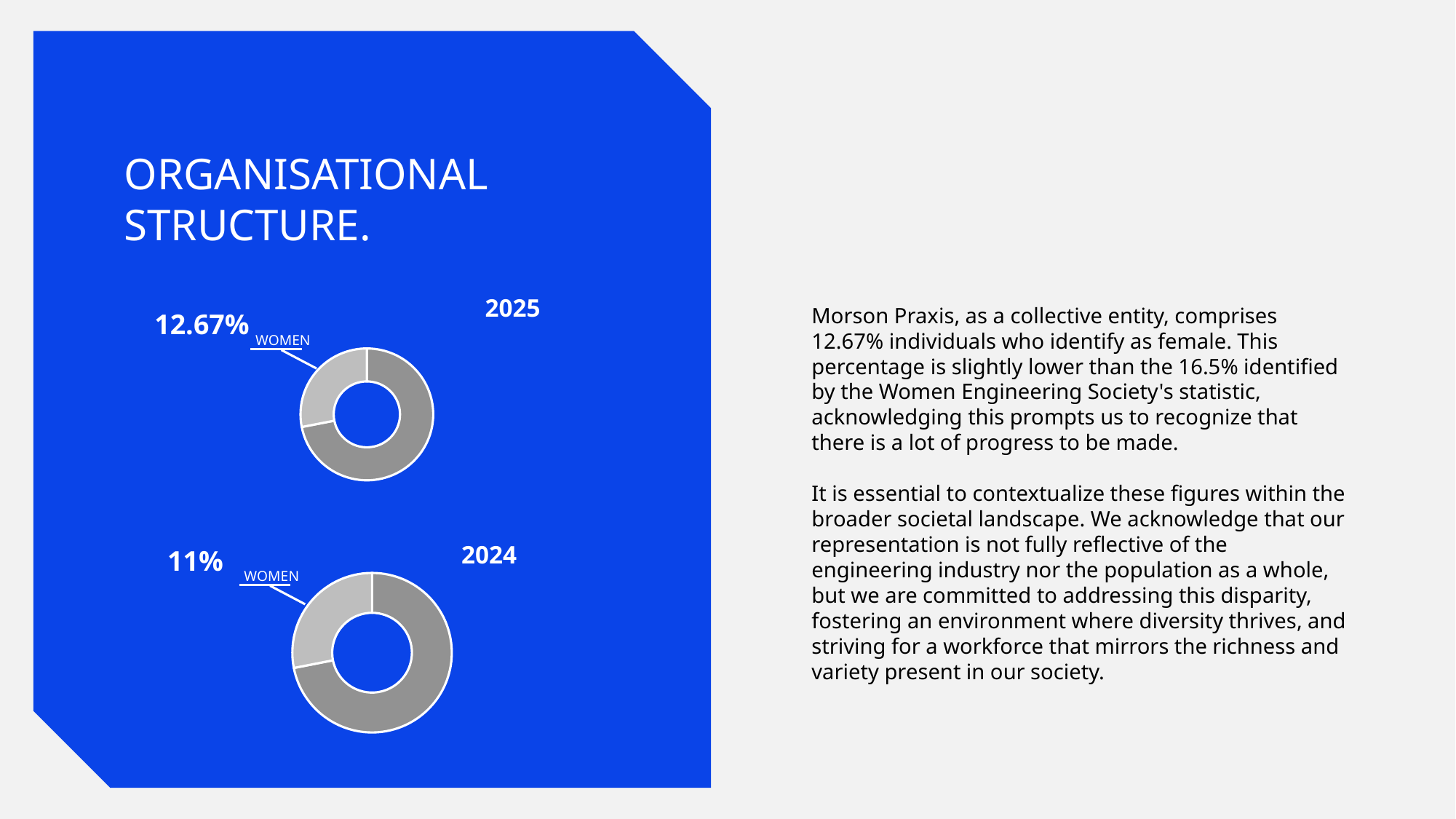
Which year's chart shows the larger share for WOMEN, 2025 or 2024? 2025 Which year is labelled on the upper donut chart? 2025 How many slices does the 2024 donut chart have? 2 Which slice is the largest in the 2024 donut chart, the WOMEN slice or the unlabelled slice? The unlabelled slice In the 2025 chart, what percentage is labelled for WOMEN? 12.67% What is the title of the slide containing the two donut charts? ORGANISATIONAL STRUCTURE. In the 2025 chart, is the WOMEN slice the smaller or the larger of the two slices? Smaller In the 2024 chart, what percentage is labelled for WOMEN? 11% What kind of chart is used for the 2025 data? Donut (pie) chart By how many percentage points does the WOMEN share in the 2025 chart exceed that in the 2024 chart? 1.67 In the 2024 chart, what share of the donut does the WOMEN slice represent? 11% How many charts are shown on the slide? 2